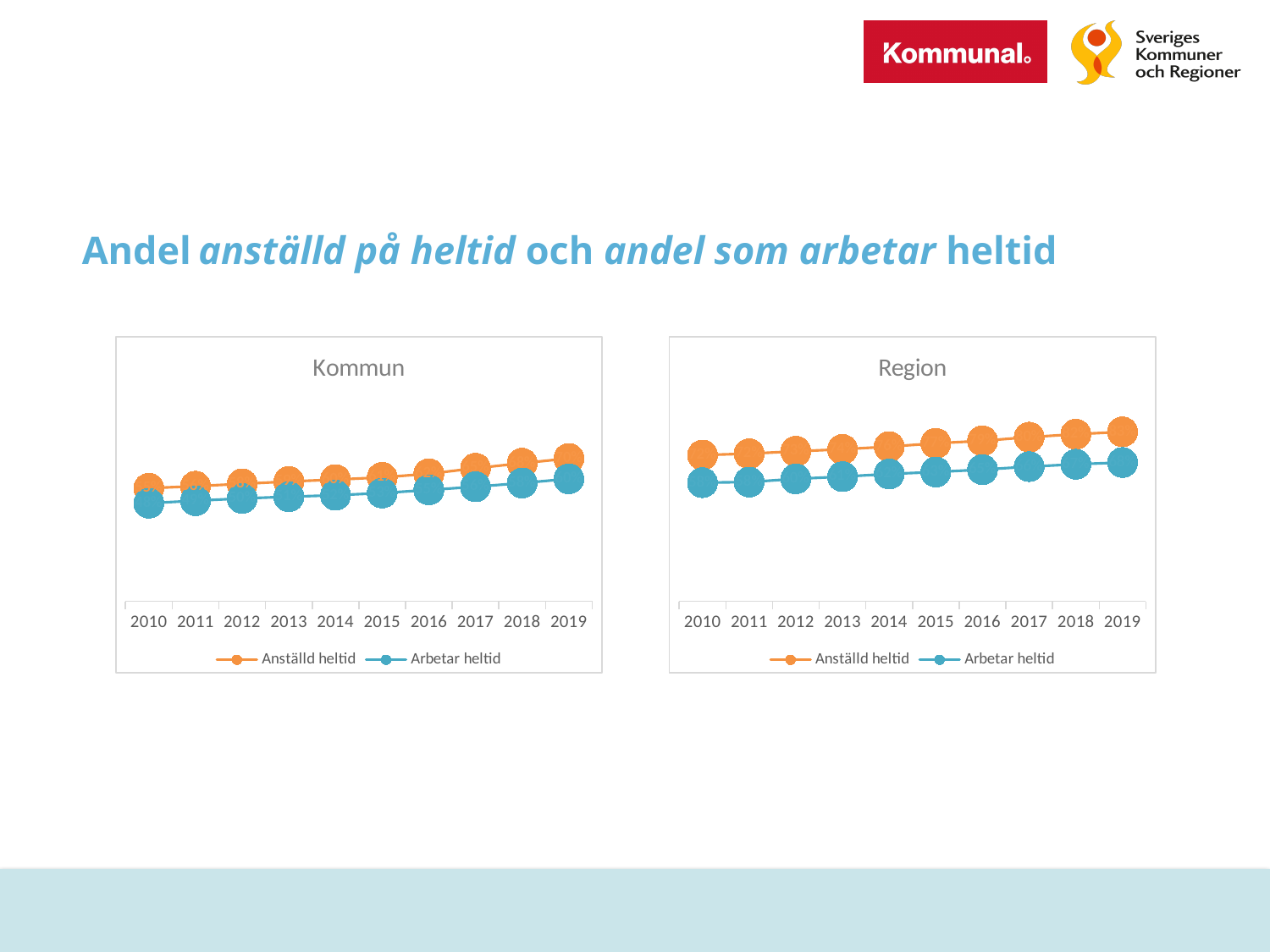
What kind of chart is the "Kommun" chart? Line chart In the "Kommun" chart, which series is higher in 2019, "Anställd heltid" or "Arbetar heltid"? Anställd heltid How many series does the legend of the "Kommun" chart list? 2 In the "Region" chart, does the "Arbetar heltid" series rise or fall from 2010 to 2019? Rise What colour is the "Arbetar heltid" line in the "Kommun" chart? Blue In the "Kommun" chart, does the "Anställd heltid" series rise or fall from 2010 to 2019? Rise How many years are shown on the x axis of the "Region" chart? 10 How many series does the legend of the "Region" chart list? 2 What kind of chart is the "Region" chart? Line chart What are the two series named in the legend of the "Region" chart? Anställd heltid and Arbetar heltid How many years are shown on the x axis of the "Kommun" chart? 10 In the "Region" chart, which series is lower in 2010, "Anställd heltid" or "Arbetar heltid"? Arbetar heltid